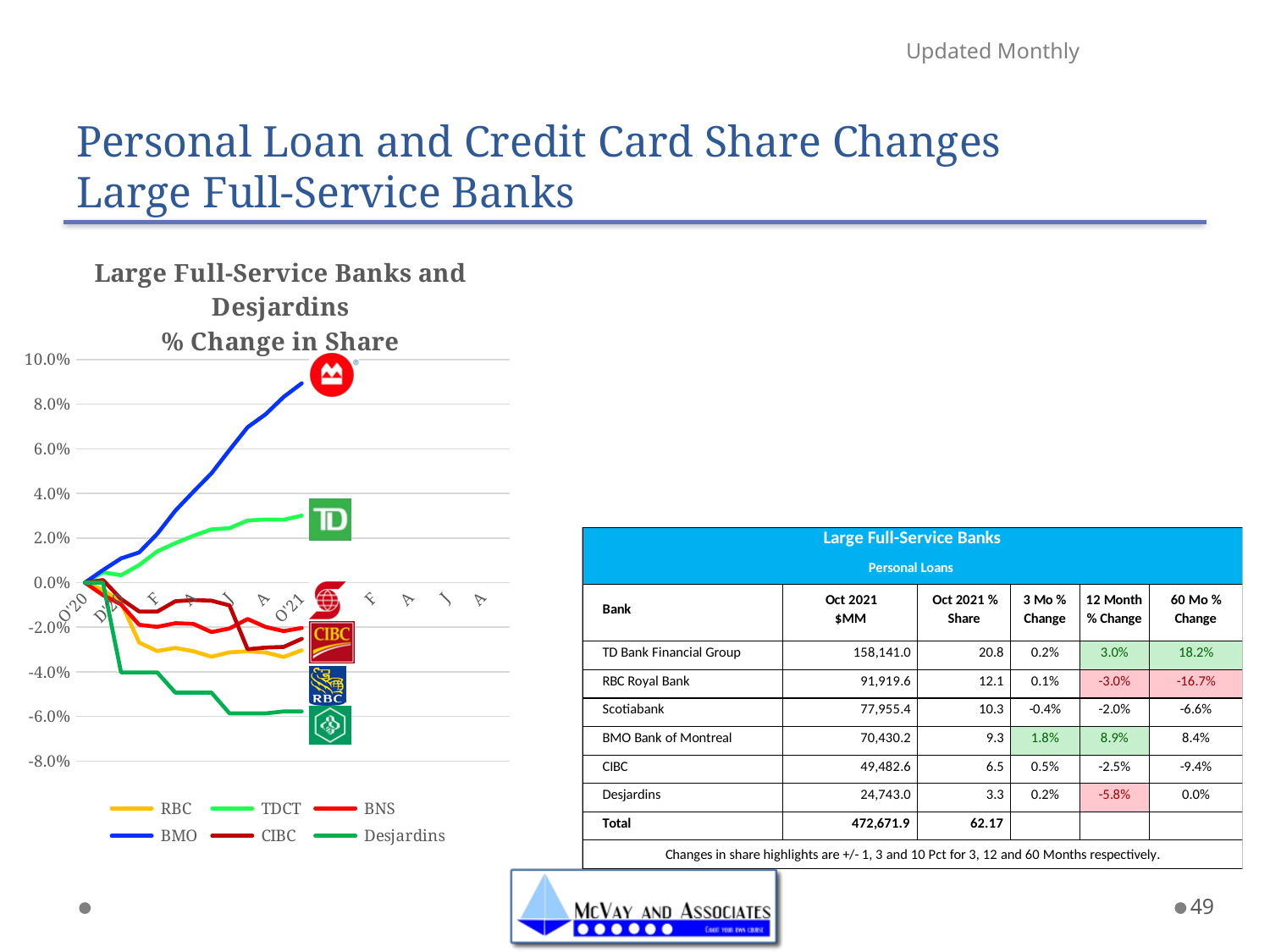
Which series has the lowest value at the right end of the chart? Desjardins Is the final value for BMO greater or less than 8.0%? greater Which series has the highest value at the right end of the chart? BMO What colour is the BMO line in the chart? blue Does the BMO line rise or fall along the x axis? rise What type of chart is shown on the slide? line chart How many series does the chart legend list? 6 What is the title of the chart? Large Full-Service Banks and Desjardins % Change in Share Does the Desjardins line rise or fall along the x axis? fall At the right end of the chart, which is larger: the value for BMO or the value for TDCT? BMO Is the final value for Desjardins greater or less than -4.0%? less Is the final value for TDCT greater or less than 2.0%? greater